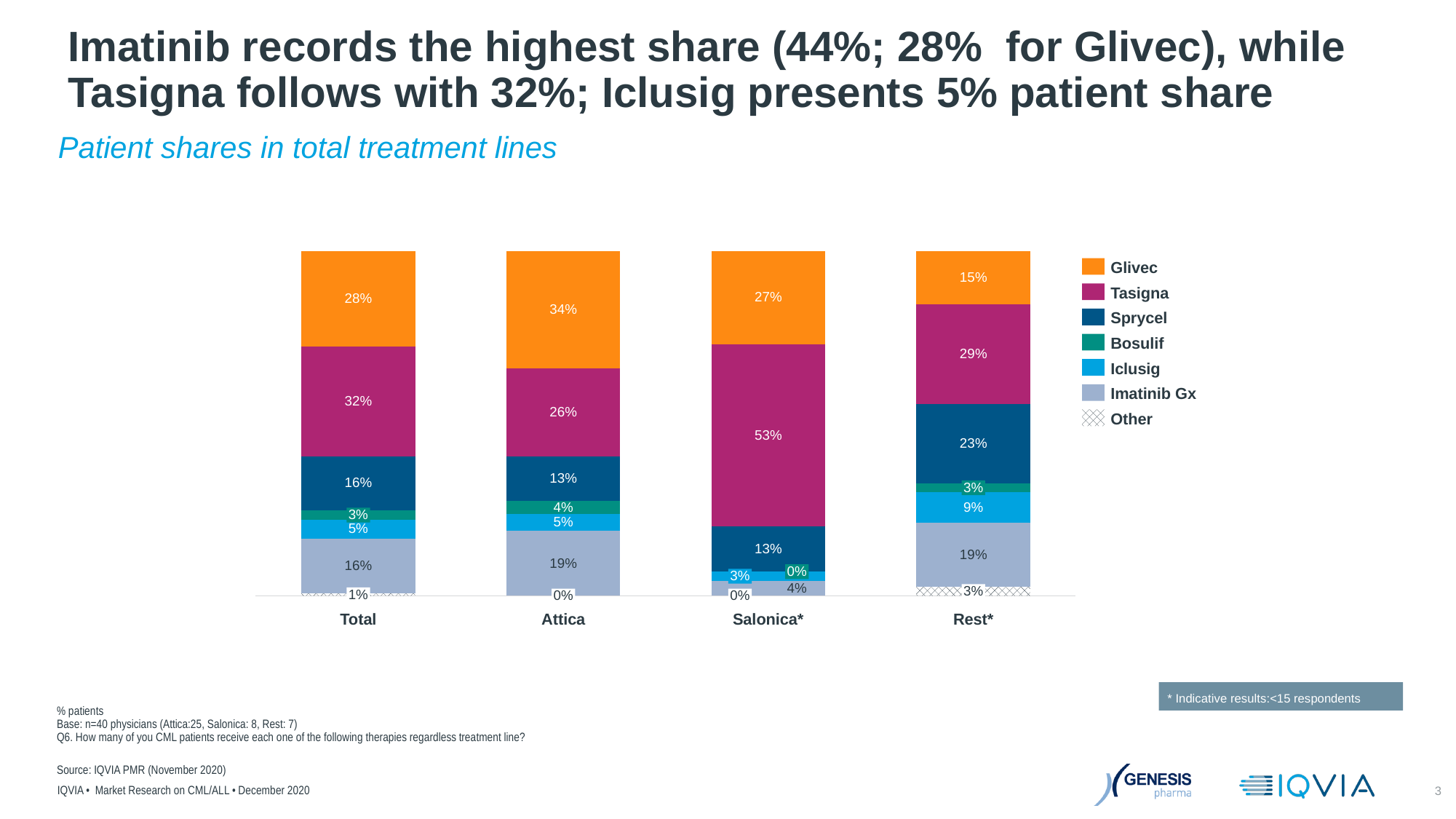
How many series does the legend list? 7 Which category has the highest Tasigna share? Salonica* Which series is shown in orange in the legend? Glivec What is the difference between the Sprycel share for Rest* and the Sprycel share for Attica? 10% What is the Iclusig share in the Total bar? 5% Which category has the lowest Glivec share? Rest* What is the Glivec share for Attica? 34% How many categories are shown along the x axis? 4 What is the Imatinib Gx share for Rest*? 19% What is the Tasigna share for Salonica*? 53% What kind of chart is shown on the slide? Stacked bar chart Which is larger: the Glivec share for Total or the Glivec share for Salonica*? Total